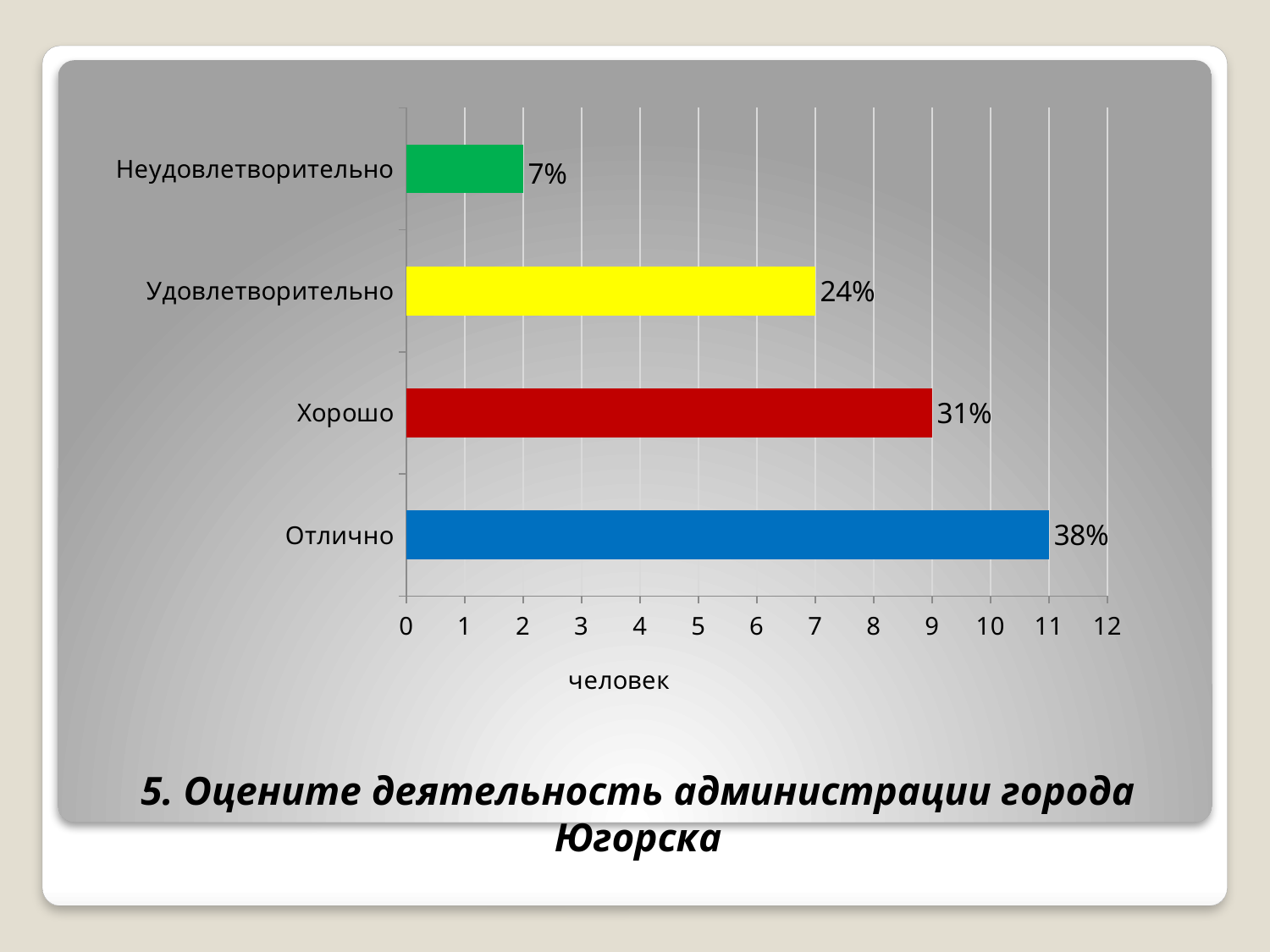
What is the difference in percentage points between Отлично and Хорошо? 7% Which is larger, the value for Хорошо or the value for Удовлетворительно? Хорошо Which category has the highest value? Отлично How many categories are shown in the chart? 4 Is the bar for Хорошо greater or less than 8 on the horizontal axis? greater What is the difference in percentage points between Удовлетворительно and Неудовлетворительно? 17% Which category has the lowest value? Неудовлетворительно What percentage is shown for the category Неудовлетворительно? 7% What is the label of the horizontal axis? человек What percentage is shown for the category Удовлетворительно? 24% What percentage is shown for the category Отлично? 38% What kind of chart is shown on the slide? bar chart